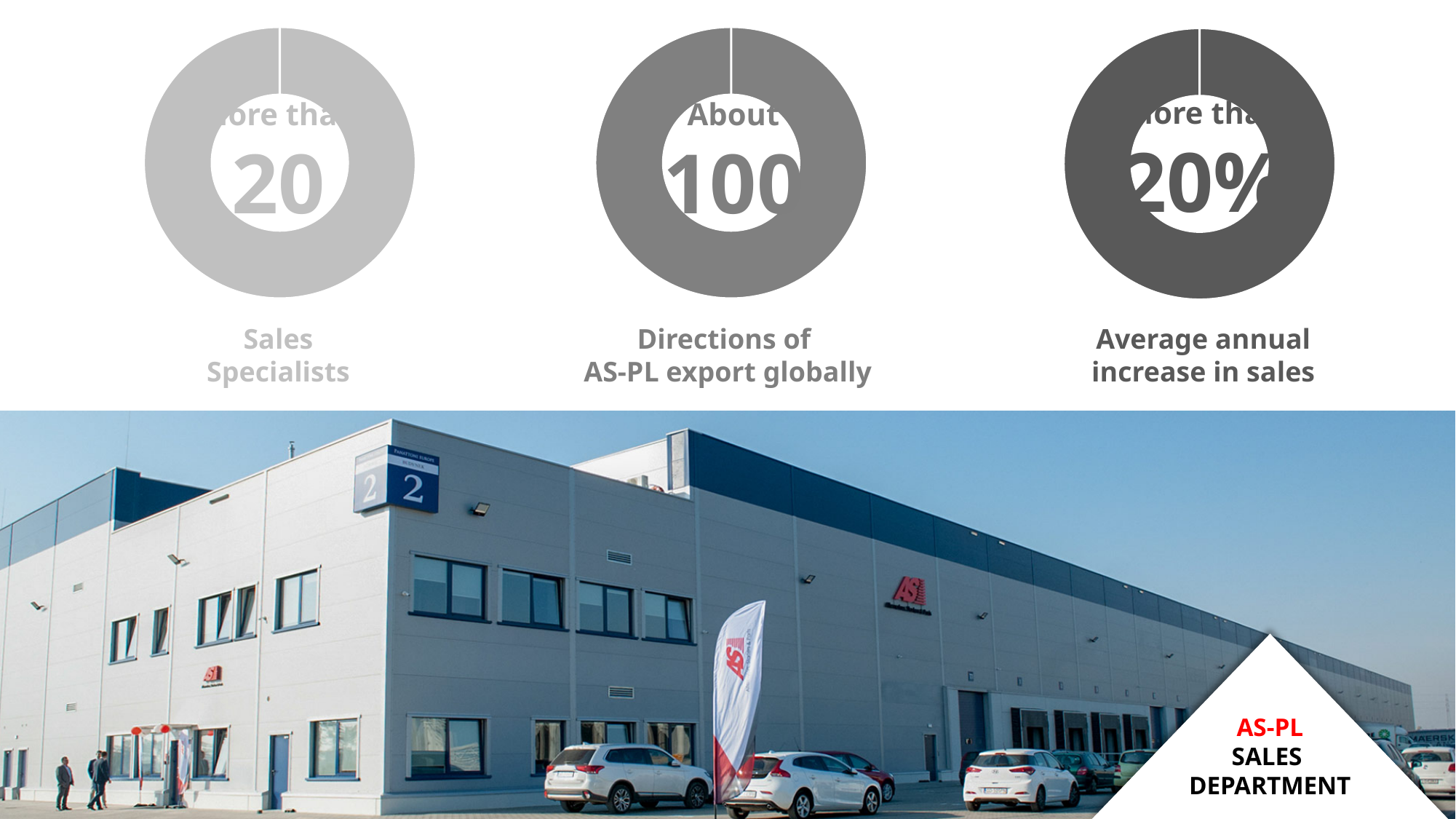
What kind of chart is used for the three statistics at the top of the slide? Donut (pie) chart What word appears above the number 100 in the middle donut chart? About What is the caption below the middle donut chart? Directions of AS-PL export globally What number is shown in the centre of the middle donut chart labelled "Directions of AS-PL export globally"? 100 Which of the three donut charts shows a percentage value? Average annual increase in sales How many donut charts are shown on the slide? 3 What number is shown in the centre of the left-hand donut chart labelled "Sales Specialists"? 20 What value is shown in the centre of the right-hand donut chart labelled "Average annual increase in sales"? 20% Which donut chart shows the larger number: the one for Sales Specialists or the one for Directions of AS-PL export globally? Directions of AS-PL export globally